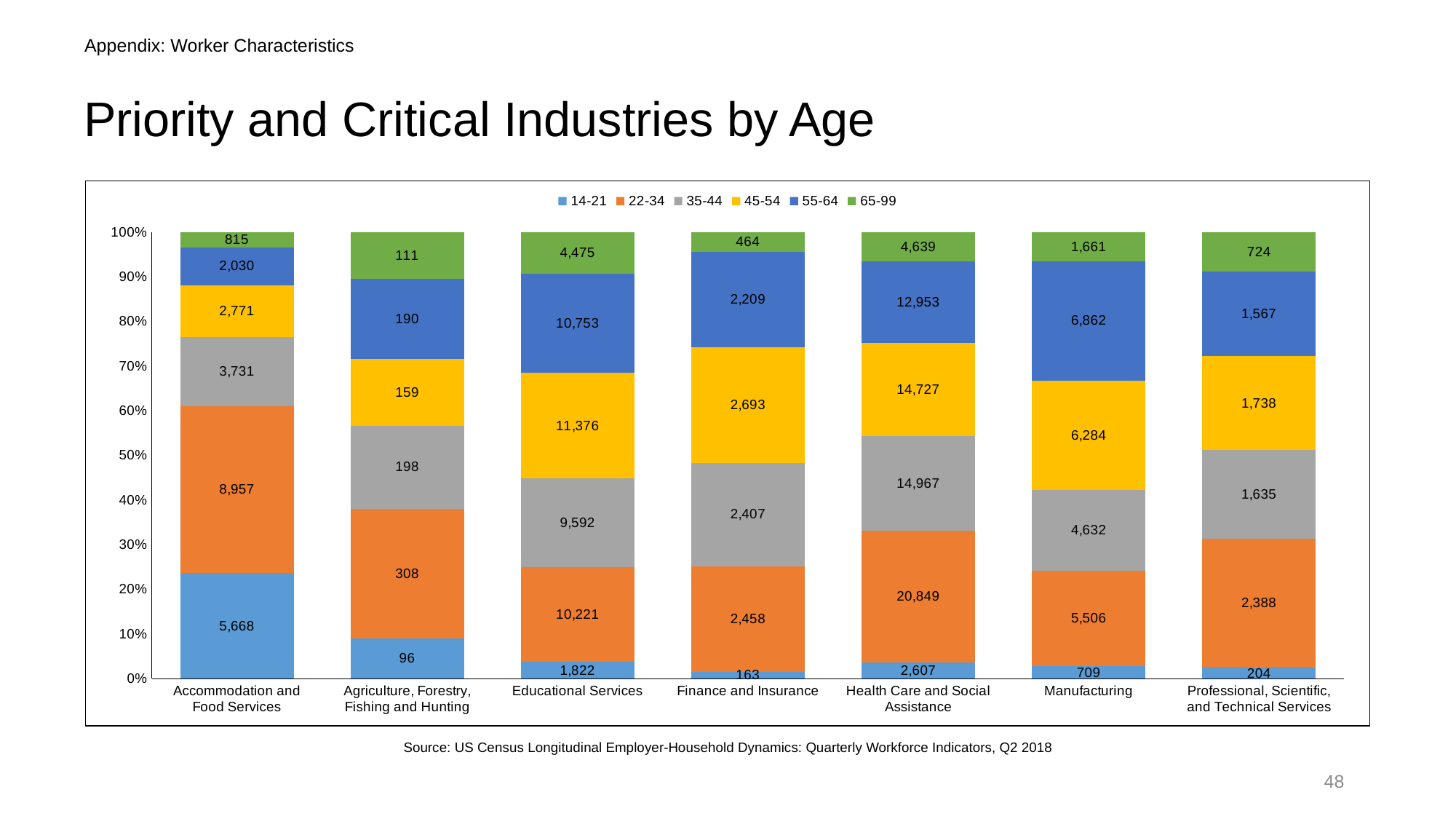
What is the value for the 45-54 age group in Educational Services? 11,376 How many industries are shown on the x axis? 7 What is the difference between the 22-34 and 35-44 values in Health Care and Social Assistance? 5,882 Is the share of the 14-21 age group in Accommodation and Food Services greater or less than 20%? greater How many age groups does the legend list? 6 What is the total of all age groups for Agriculture, Forestry, Fishing and Hunting? 1,062 Which industry has the highest value for the 22-34 age group? Health Care and Social Assistance What kind of chart is shown? Stacked bar chart What is the value for the 65-99 age group in Manufacturing? 1,661 Which is larger in Manufacturing: the 55-64 value or the 45-54 value? 55-64 What is the value for the 22-34 age group in Health Care and Social Assistance? 20,849 Which industry has the lowest value for the 14-21 age group? Agriculture, Forestry, Fishing and Hunting